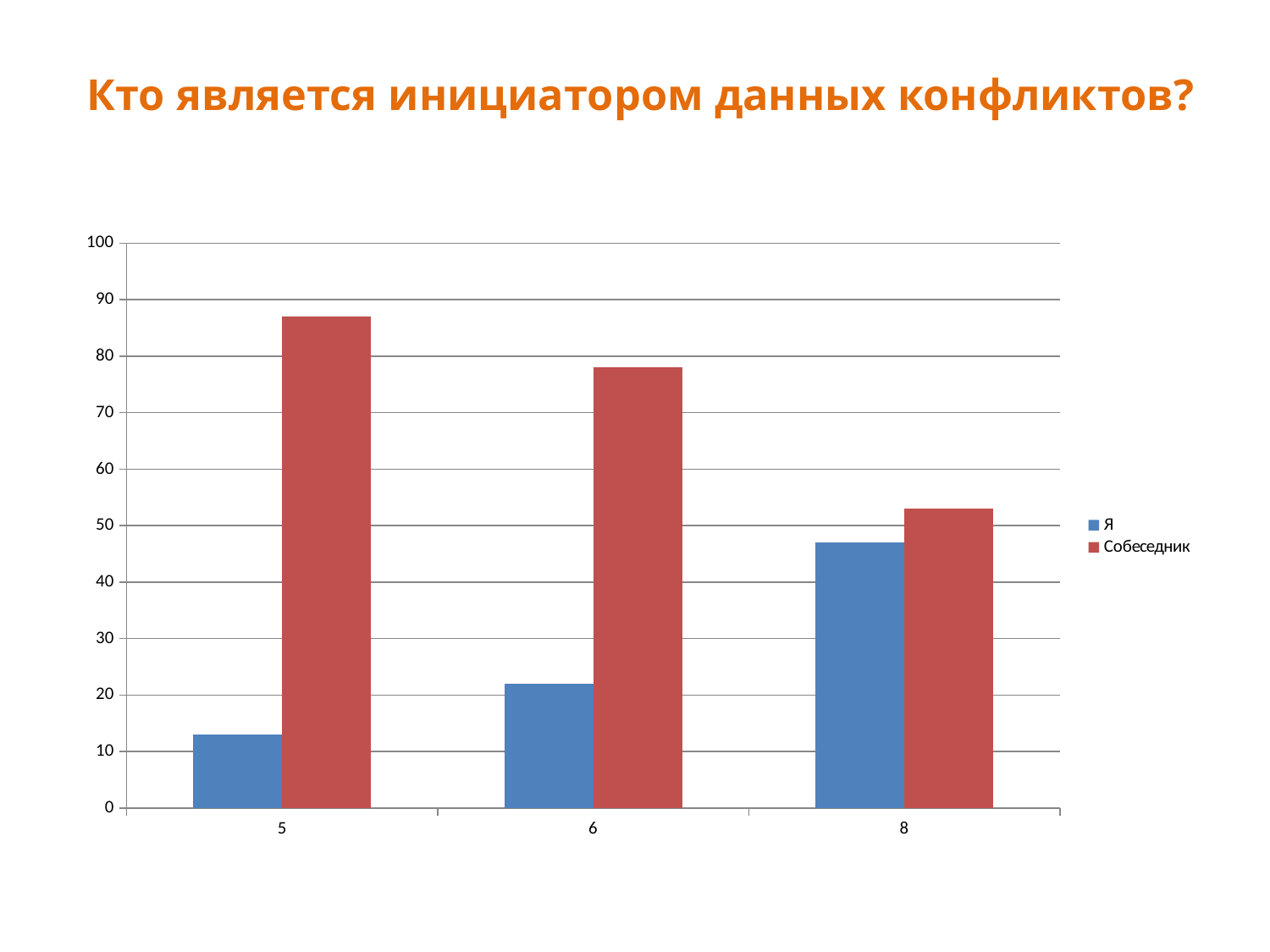
How many series does the legend list? 2 For which category is the value of the Я series highest? 8 Is the value for Собеседник in category 5 greater or less than 80? greater Is the value for Я in category 6 greater or less than 30? less For category 5, which series has the larger value, Я or Собеседник? Собеседник What is the title of the chart on the slide? Кто является инициатором данных конфликтов? Which series is shown in red? Собеседник Do the values of the Собеседник series rise or fall from category 5 to category 8? fall What kind of chart is shown on the slide? bar chart How many categories are shown on the x axis? 3 For which category is the value of the Собеседник series lowest? 8 Do the values of the Я series rise or fall from category 5 to category 8? rise